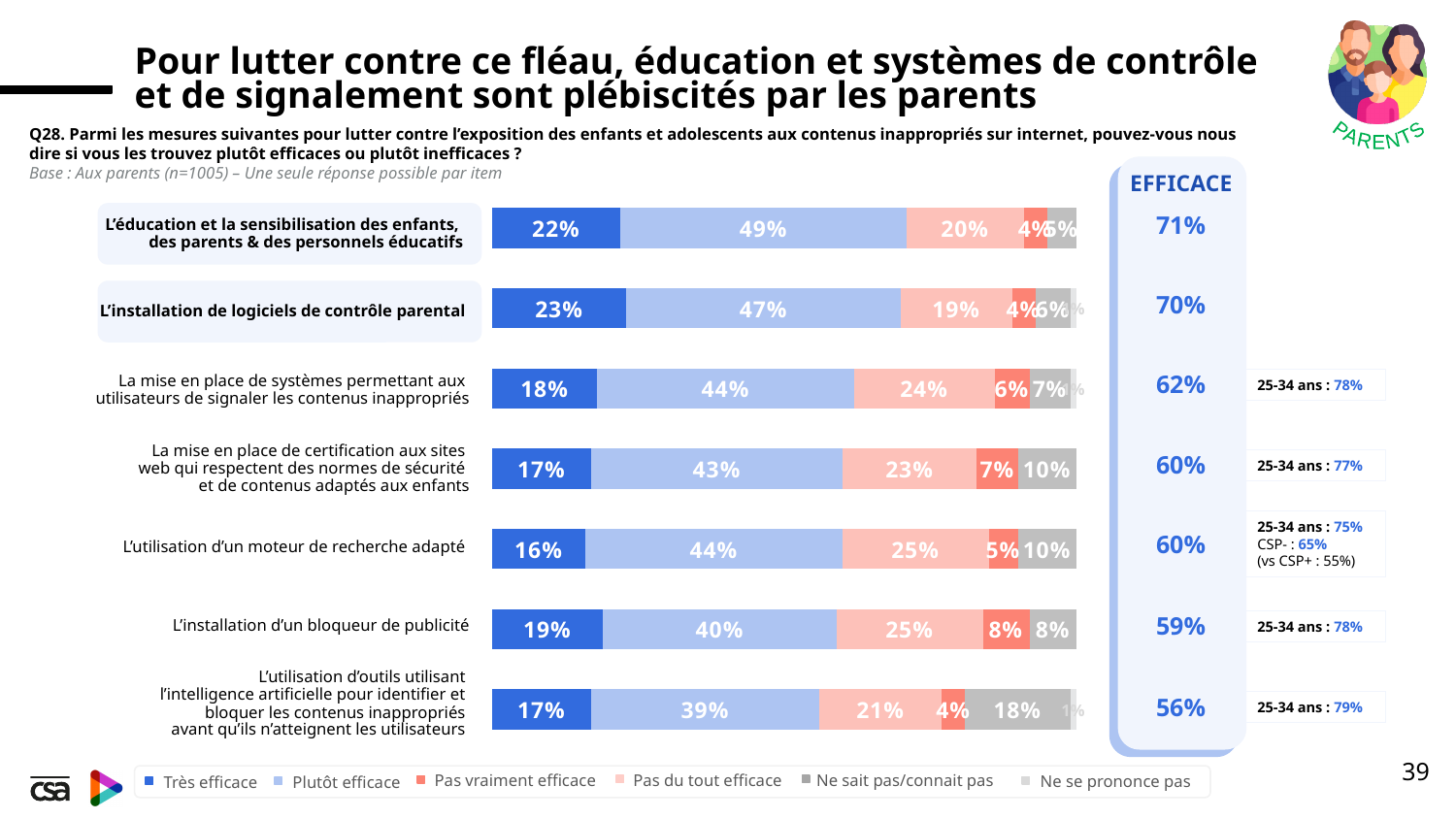
What is the 'Ne sait pas/connait pas' value for 'L'utilisation d'outils utilisant l'intelligence artificielle...'? 18% What is the difference between the EFFICACE value for 'L'éducation et la sensibilisation...' (71%) and for 'L'utilisation d'outils utilisant l'intelligence artificielle...' (56%)? 15 points Which has the larger 'Pas vraiment efficace' value: 'L'utilisation d'un moteur de recherche adapté' or 'L'installation de logiciels de contrôle parental'? L'utilisation d'un moteur de recherche adapté Which measure has the lowest 'Très efficace' value? L'utilisation d'un moteur de recherche adapté What is the EFFICACE value for 'L'installation d'un bloqueur de publicité'? 59% Which measure has the highest 'Très efficace' value? L'installation de logiciels de contrôle parental What is the 'Plutôt efficace' value for 'L'éducation et la sensibilisation des enfants, des parents & des personnels éducatifs'? 49% What is the 'Très efficace' value for 'L'installation de logiciels de contrôle parental'? 23% How many measures (categories) are plotted in the chart? 7 What is the combined 'Très efficace' plus 'Plutôt efficace' total for 'La mise en place de certification aux sites web...'? 60% What kind of chart is shown on the slide? Stacked bar chart How many series does the legend list? 6